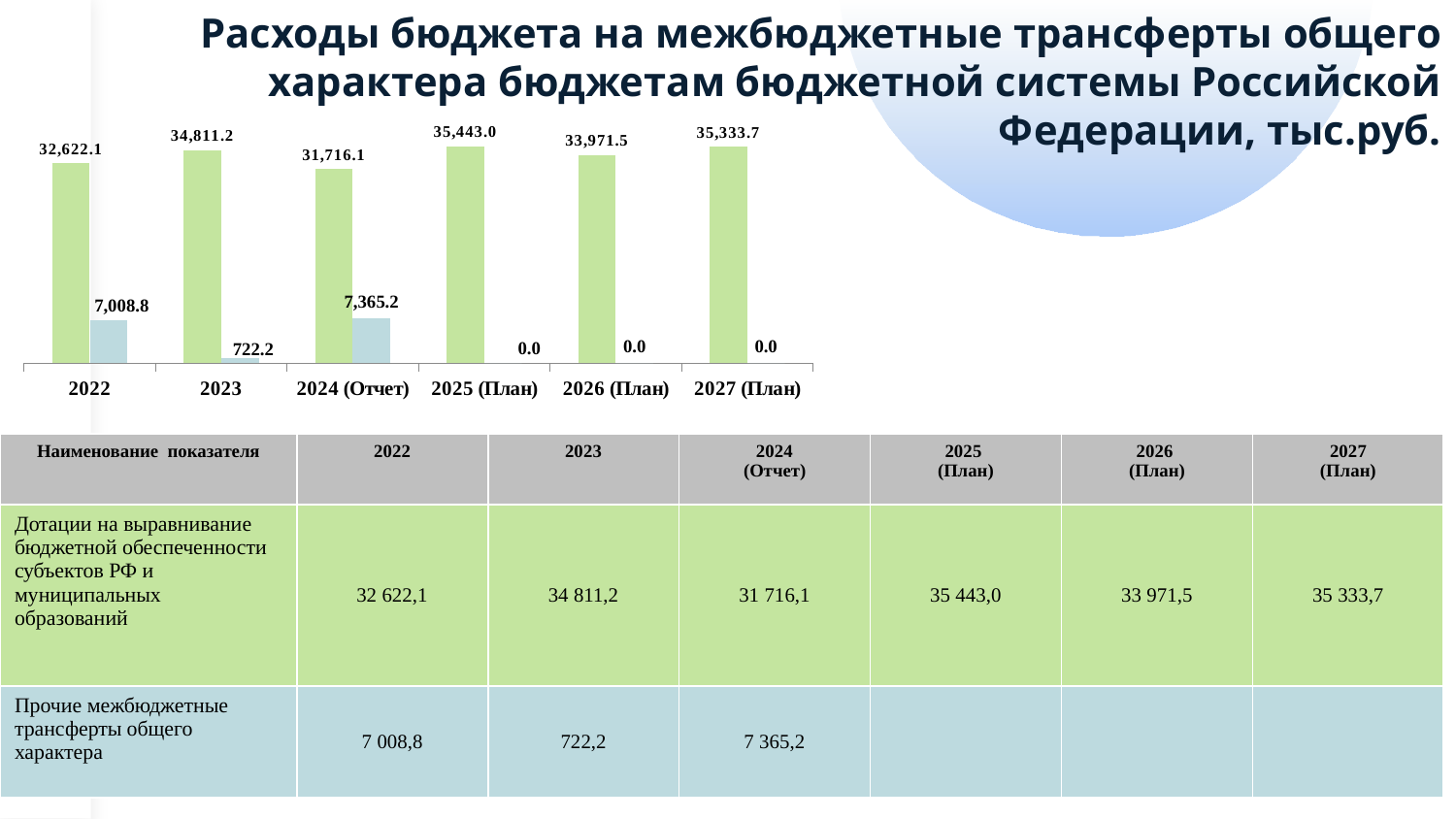
What is the difference between the green bar values for 2023 and 2022? 2,189.1 Which year has the highest green bar? 2025 (План) Which year has the lowest green bar? 2024 (Отчет) How many year categories are shown on the x axis of the chart? 6 What is the difference between the light blue bar values for 2024 (Отчет) and 2023? 6,643.0 What is the value of the green bar for 2025 (План)? 35,443.0 Which year has the highest light blue bar? 2024 (Отчет) Which is larger: the green bar for 2026 (План) or the green bar for 2027 (План)? 2027 (План) What is the value of the light blue bar for 2026 (План)? 0.0 What is the value of the light blue bar for 2022? 7,008.8 What kind of chart is shown on the slide? Bar chart What is the value of the light blue bar for 2023? 722.2